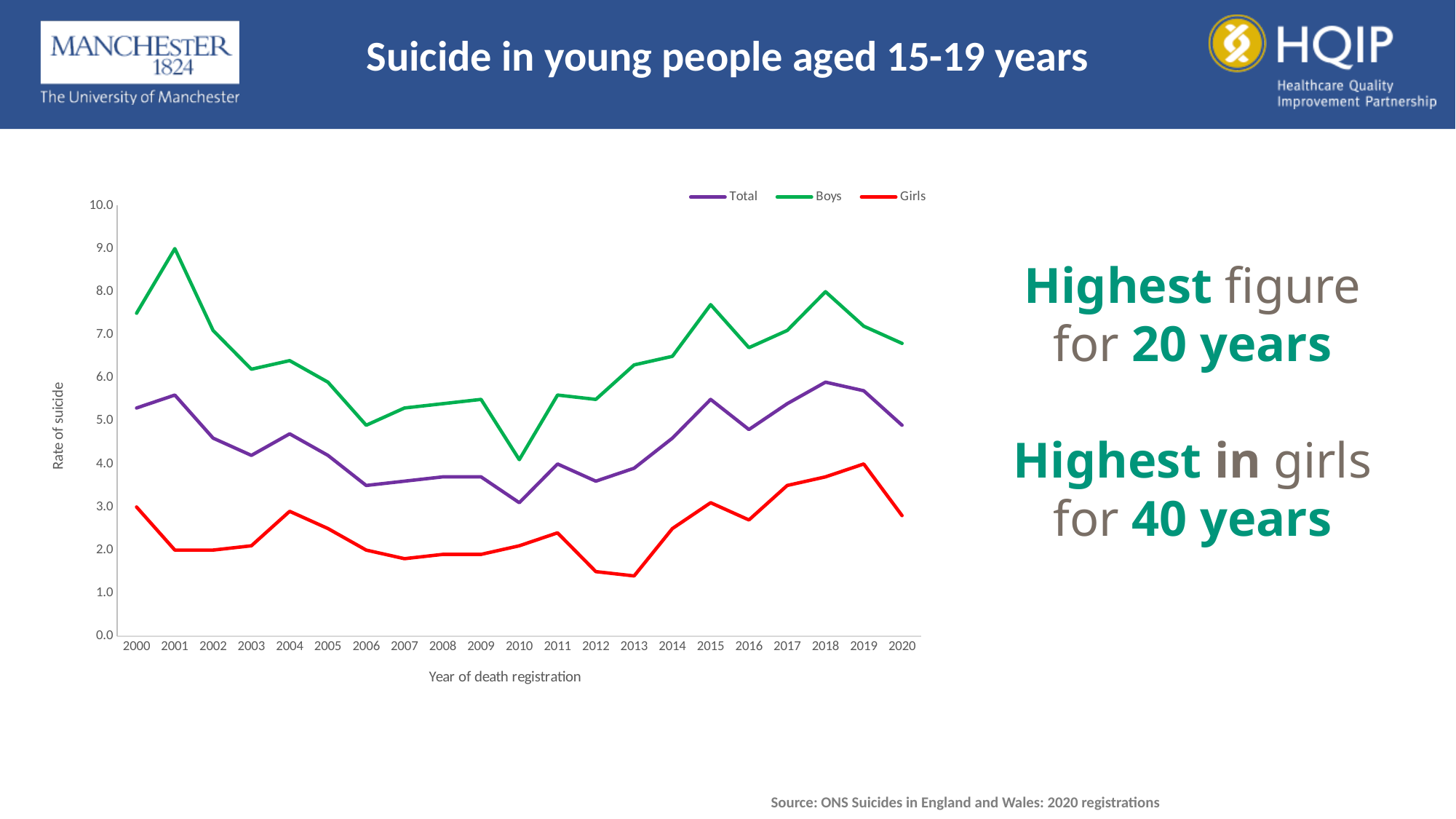
How many years are plotted along the x axis? 21 Which series has the higher value in 2020, Boys or Girls? Boys What kind of chart is shown on the slide? Line chart In which year is the Girls series at its highest? 2019 What is the label on the x axis of the chart? Year of death registration How many series does the legend list? 3 Is the value for Boys in 2001 greater or less than 8.0? greater Does the Girls series rise or fall between 2013 and 2019? Rise In which year is the Boys series at its highest? 2001 In which year is the Boys series at its lowest? 2010 In which year is the Girls series at its lowest? 2013 Is the value for Total in 2010 greater or less than 4.0? less